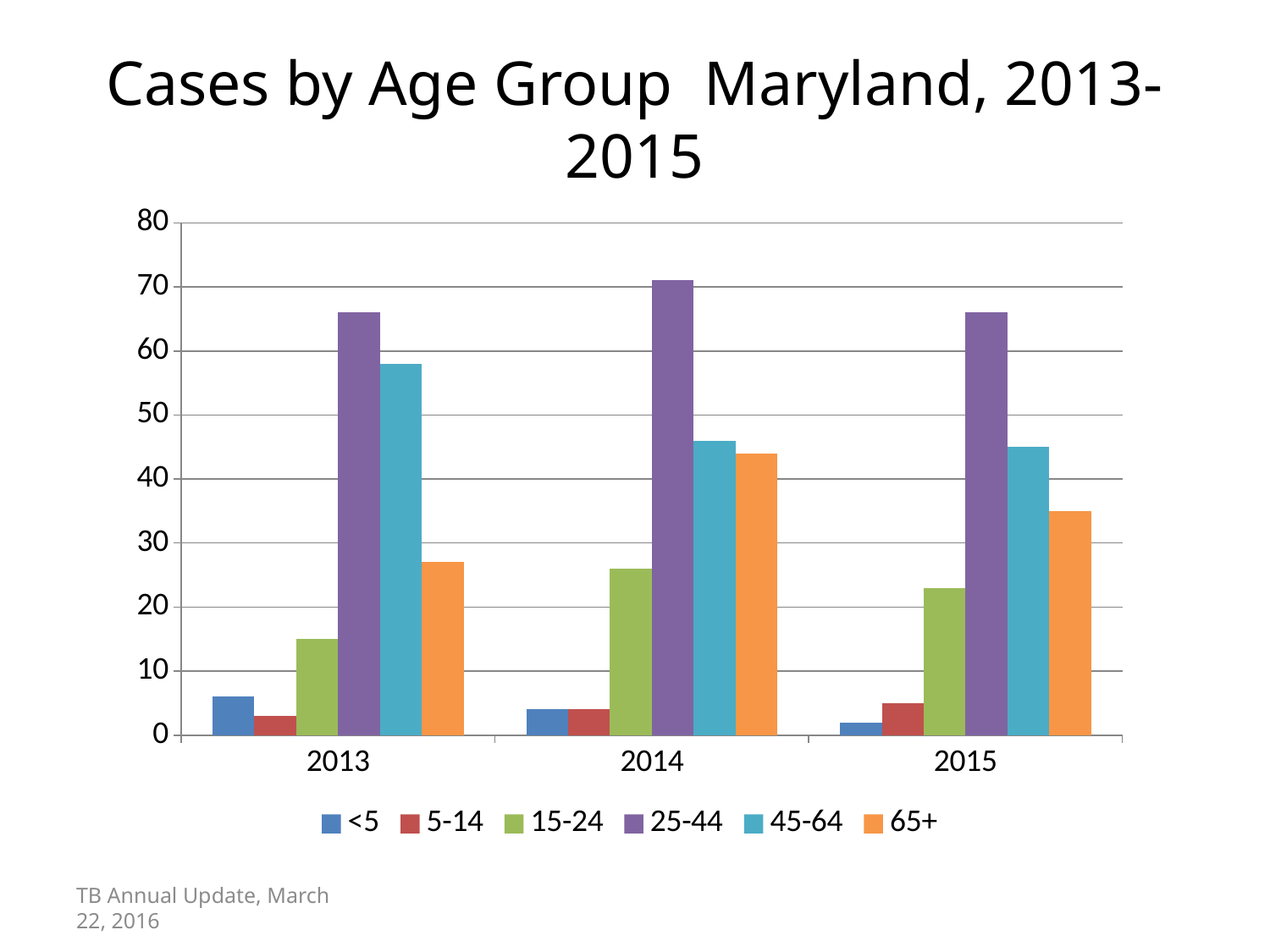
Is the value for the 25-44 age group in 2014 greater or less than 60? greater What is the title of the chart? Cases by Age Group Maryland, 2013-2015 How many series does the legend list? 6 Which age group has the lowest number of cases in 2013? 5-14 In 2015, which is larger: the value for 45-64 or the value for 65+? 45-64 What kind of chart is shown on the slide? bar chart How many years are shown on the x axis? 3 Which age group has the lowest number of cases in 2015? <5 Is the value for the 45-64 age group in 2013 greater or less than 50? greater Is the value for the 65+ age group in 2013 greater or less than 30? less Does the value for the 65+ age group rise or fall from 2013 to 2014? rise Which age group has the highest number of cases in 2014? 25-44